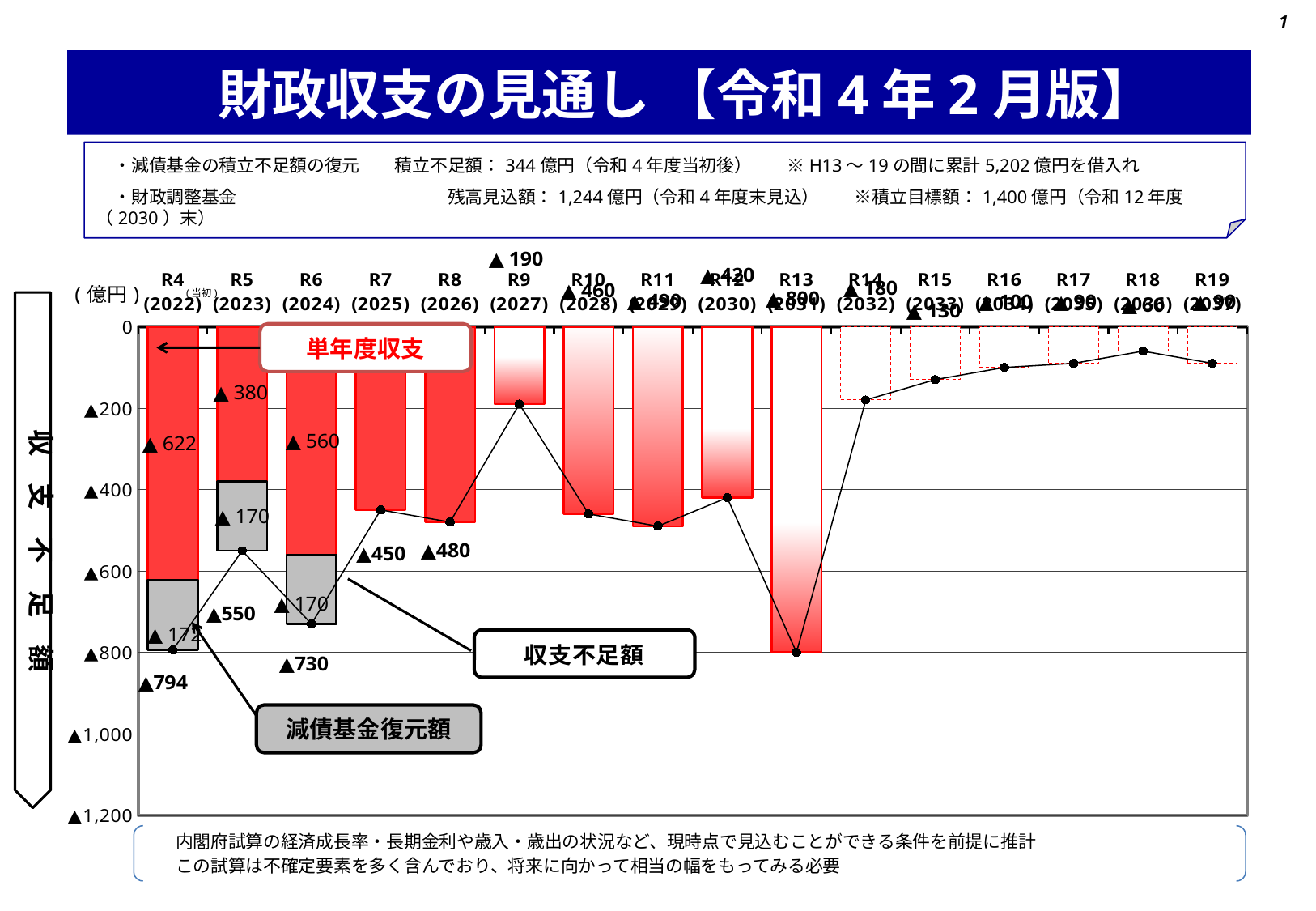
What does the gray portion of the bars represent, according to the label on the chart? 減債基金復元額 How many fiscal years are shown on the x axis? 16 Which has the larger 収支不足額, R7 (2025) or R8 (2026)? R8 (2026) What is the total of the stacked bar for R6 (2024), combining 単年度収支 and 減債基金復元額? ▲730 Does the line point for R11 (2029) lie above or below the ▲400 gridline? below What is the 単年度収支 (red bar) value for R6 (2024)? ▲560 What is the 収支不足額 value shown for R4 (2022)? ▲794 From R14 (2032) to R18 (2036), does the 収支不足額 line move closer to 0 or further from 0? Closer to 0 What is the 収支不足額 value labelled for R15 (2033)? ▲130 What is the difference between the 収支不足額 for R4 (2022) and R5 (2023)? 244 What kind of chart is this? Combination of a stacked bar chart and a line chart What is the 減債基金復元額 (gray bar) value for R5 (2023)? ▲170